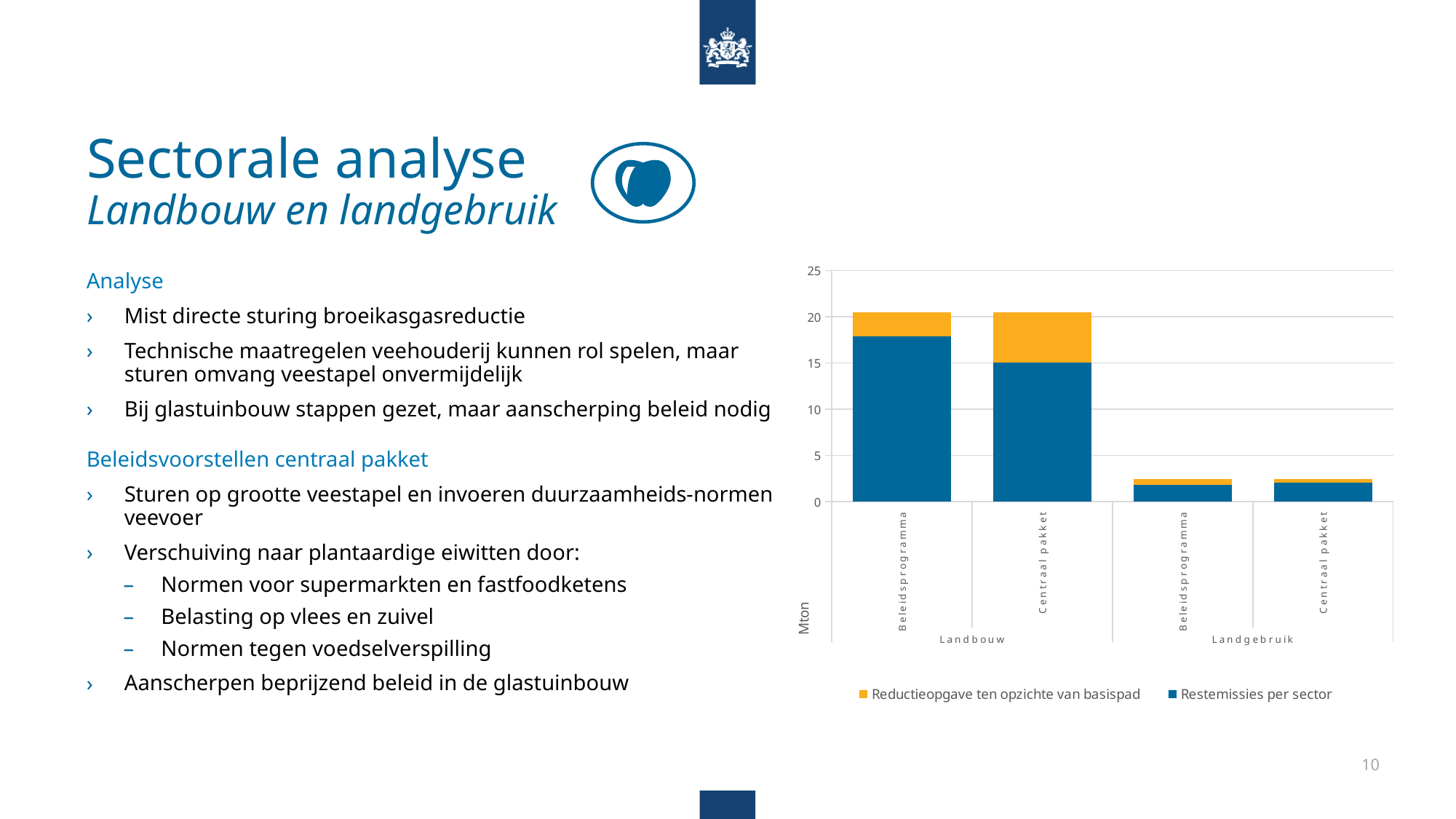
Is the total stacked bar for Beleidsprogramma under Landgebruik greater or less than 5? less Which colour represents 'Restemissies per sector' in the chart? Blue Is the 'Restemissies per sector' value for Beleidsprogramma under Landbouw greater or less than 15? greater Is the 'Restemissies per sector' value for Centraal pakket under Landbouw greater or less than 20? less Which has the larger 'Restemissies per sector' value: Beleidsprogramma or Centraal pakket under Landbouw? Beleidsprogramma Which bar has the highest 'Restemissies per sector' value? Beleidsprogramma (Landbouw) How many series does the chart legend list? 2 What kind of chart is shown on the slide? Stacked bar chart Which has the larger 'Reductieopgave ten opzichte van basispad' value: Beleidsprogramma or Centraal pakket under Landbouw? Centraal pakket How many bars are plotted in the chart? 4 What unit is shown on the vertical axis of the chart? Mton